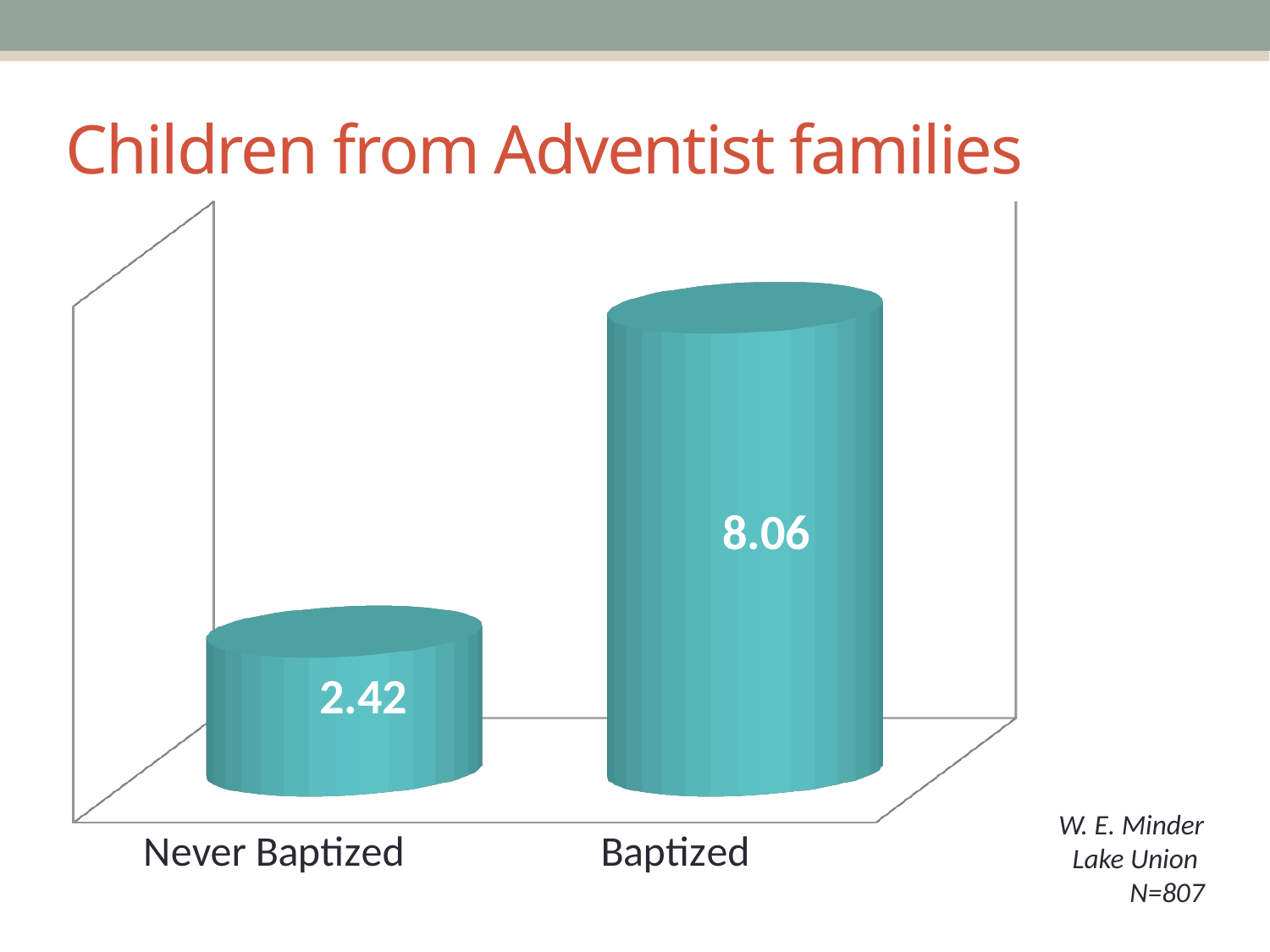
What sample size (N) is noted on the slide? N=807 What is the difference between the values for Baptized and Never Baptized? 5.64 Which category has the lowest value? Never Baptized What is the value for Baptized? 8.06 What is the title of the slide containing the chart? Children from Adventist families How many categories are shown in the chart? 2 What kind of chart is shown on the slide? Bar chart Which category has the highest value? Baptized Which is larger, the value for Baptized or the value for Never Baptized? Baptized What is the value for Never Baptized? 2.42 Do the values rise or fall from Never Baptized to Baptized? Rise